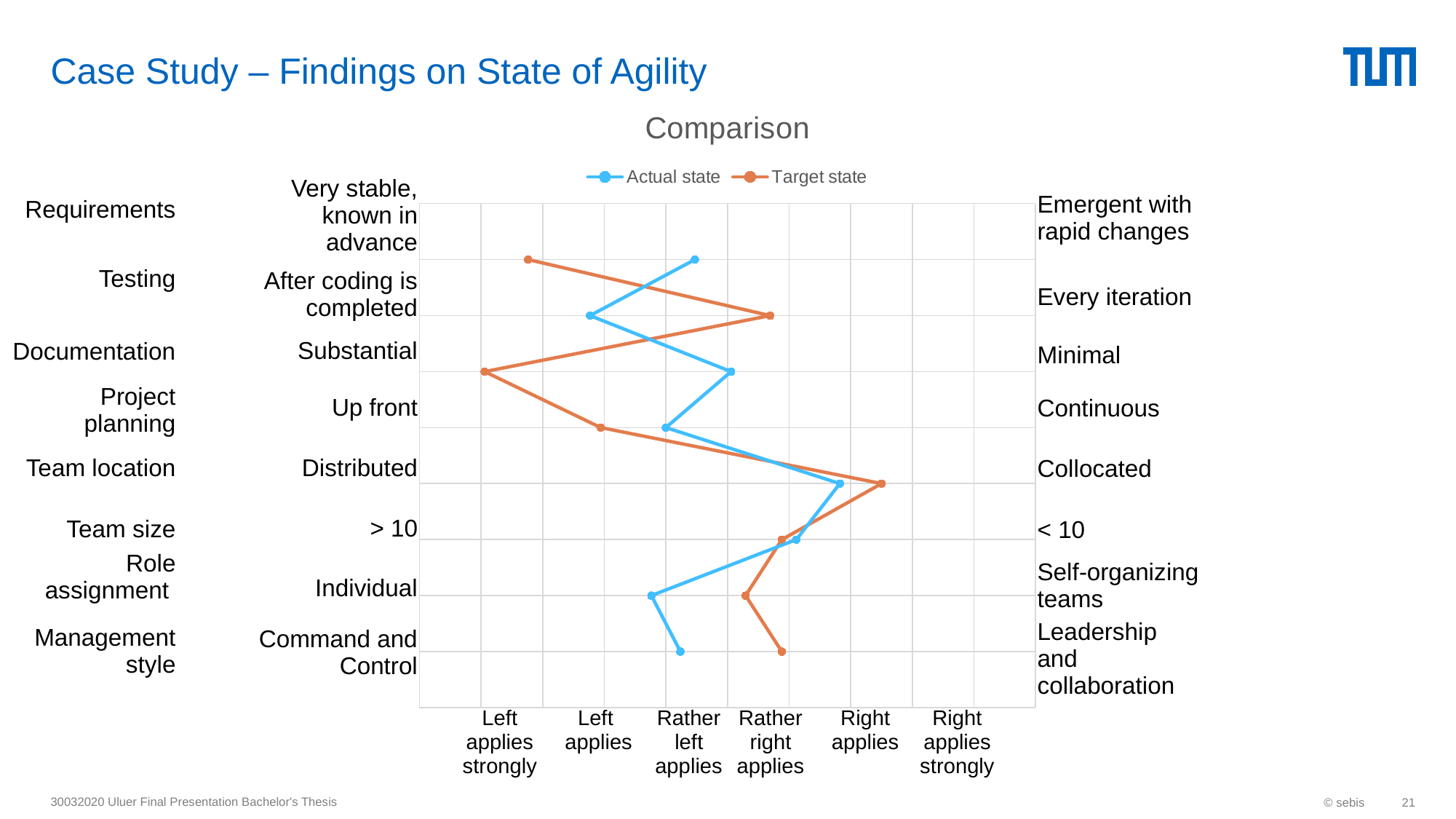
For Testing, which series lies further to the right, Actual state or Target state? Target state What type of chart is shown on the slide? Line chart For which category is the Target state point furthest to the left? Documentation What is the title of the chart? Comparison For which category is the Actual state point furthest to the right? Team location How many categories (rows) are plotted in the chart? 8 For Role assignment, which series lies further to the right, Actual state or Target state? Target state For Management style, which series lies further to the right, Actual state or Target state? Target state How many series does the legend list? 2 Which series is drawn in orange? Target state